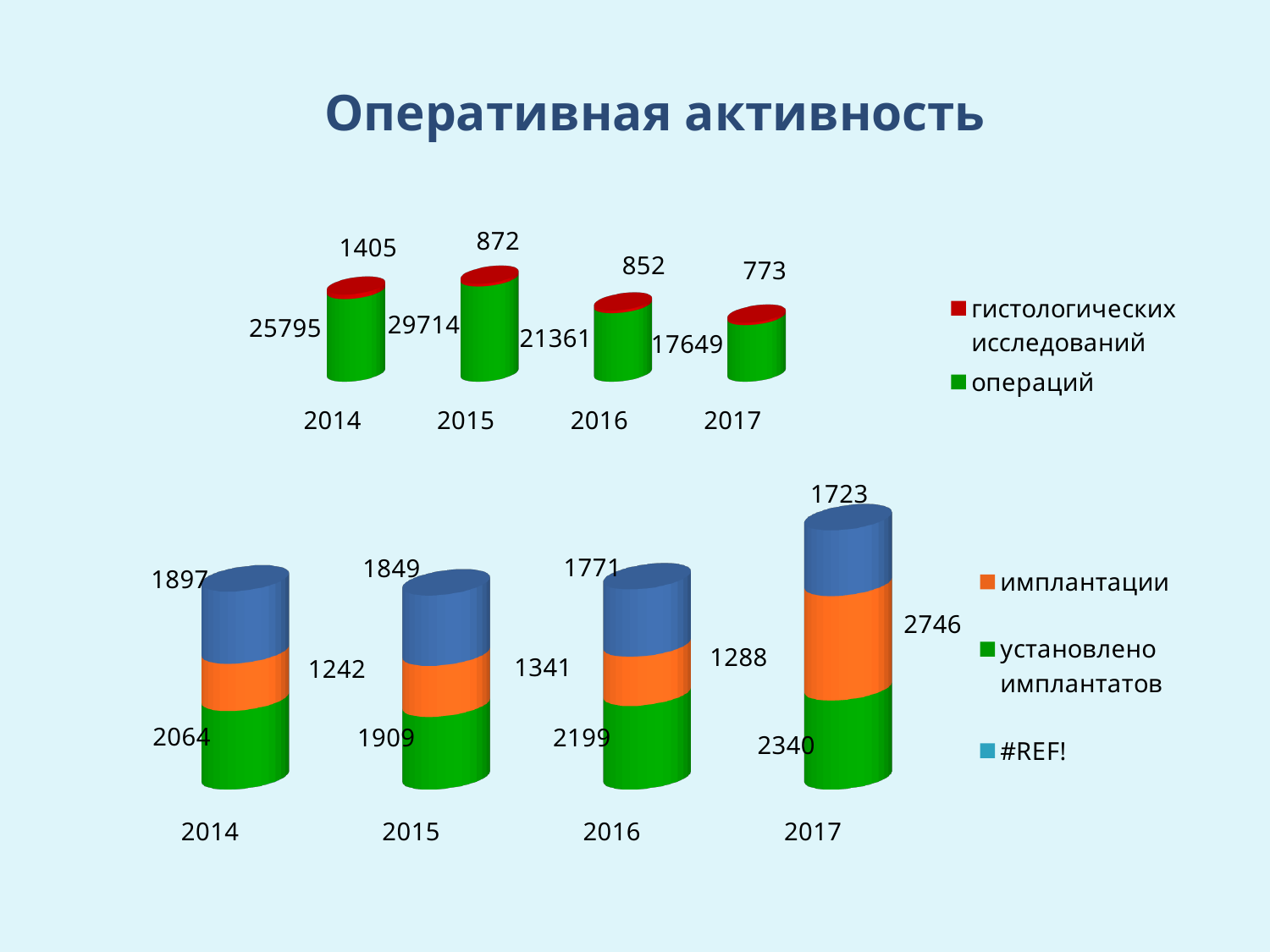
In the top chart, which year has the highest value for гистологических исследований? 2014 In the bottom chart, is the value for имплантации larger in 2015 or in 2016? 2015 In the bottom chart, which year has the highest value for установлено имплантатов? 2017 In the top chart, what is the value for операций in 2015? 29714 In the bottom chart, what is the value for имплантации in 2017? 2746 What is the title of the slide? Оперативная активность In the top chart, what is the difference between операций in 2015 and 2017? 12065 In the top chart, which year has the lowest value for операций? 2017 In the bottom chart, how many years are shown on the x axis? 4 In the top chart, how many series does the legend list? 2 In the bottom chart, what is the value for установлено имплантатов in 2016? 2199 In the top chart, what is the value for гистологических исследований in 2014? 1405